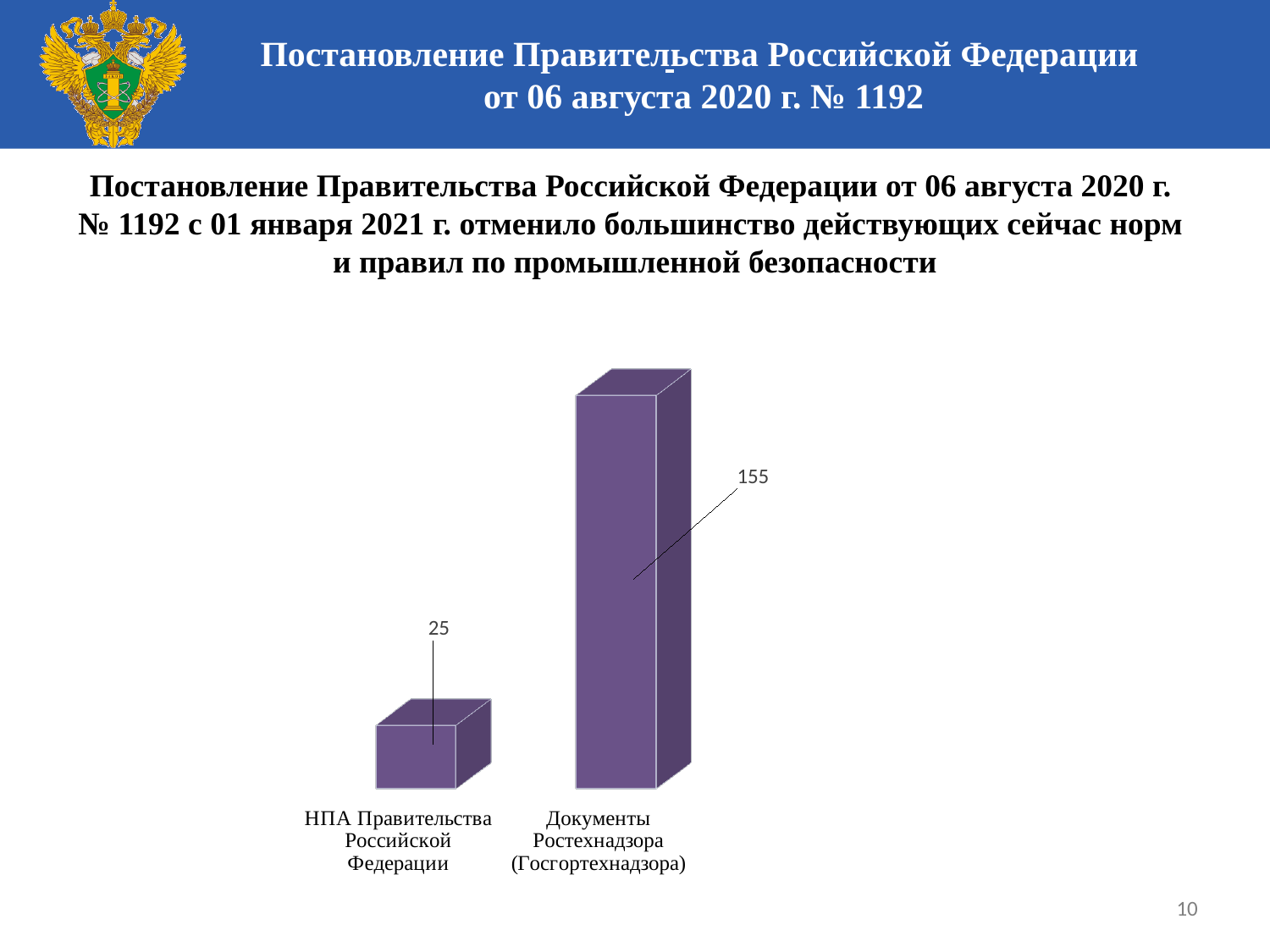
What is the value for Документы Ростехнадзора (Госгортехнадзора)? 155 How many categories are shown in the chart? 2 Which category has the lowest value? НПА Правительства Российской Федерации What colour are the bars in the chart? Purple What is the value for НПА Правительства Российской Федерации? 25 Which category has the highest value? Документы Ростехнадзора (Госгортехнадзора) What kind of chart is shown on the slide? Bar chart Which is larger: the value for НПА Правительства Российской Федерации or the value for Документы Ростехнадзора (Госгортехнадзора)? Документы Ростехнадзора (Госгортехнадзора) What is the total of the two values shown in the chart? 180 What is the difference between the values for Документы Ростехнадзора (Госгортехнадзора) and НПА Правительства Российской Федерации? 130